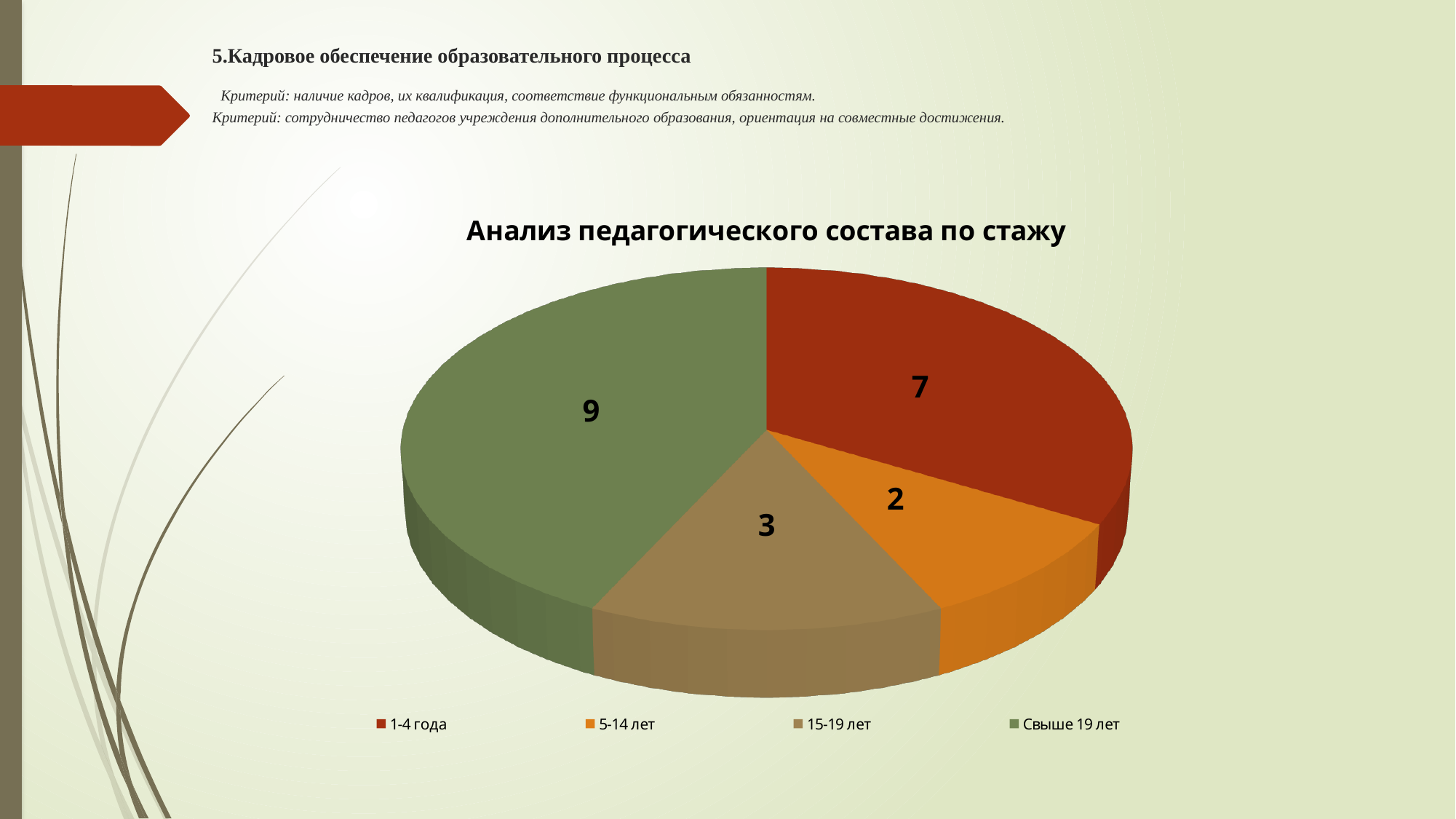
What is the value for the category "Свыше 19 лет"? 9 What is the total of all the values shown in the pie chart? 21 How many categories does the pie chart have? 4 Which is larger, the value for "15-19 лет" or the value for "5-14 лет"? 15-19 лет What type of chart is shown on the slide? pie chart Which category has the largest slice of the pie? Свыше 19 лет What is the value for the category "15-19 лет"? 3 What is the title of the chart? Анализ педагогического состава по стажу What is the value for the category "1-4 года"? 7 What is the difference between the values for "Свыше 19 лет" and "1-4 года"? 2 What is the value for the category "5-14 лет"? 2 Which category has the smallest slice of the pie? 5-14 лет